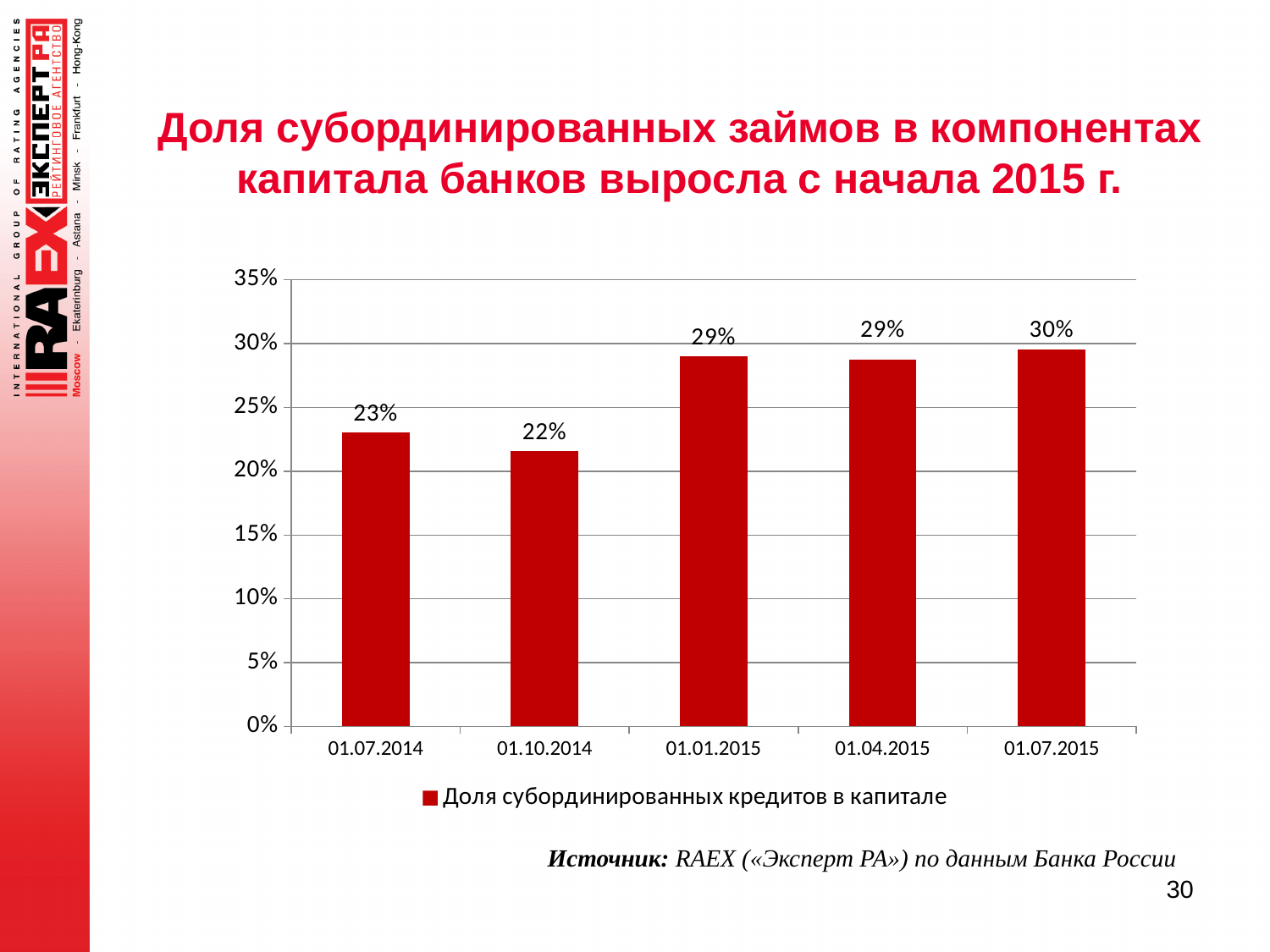
What is the difference between the values for 01.07.2015 and 01.10.2014? 8 percentage points What is the value for 01.01.2015? 29% What is the value for 01.10.2014? 22% What is the value for 01.07.2014? 23% What kind of chart is shown on the slide? bar chart How many dates are shown on the x axis? 5 Is the value for 01.04.2015 greater or less than 25%? greater Which date has the lowest value? 01.10.2014 What is the legend entry for the series shown? Доля субординированных кредитов в капитале Which date has the highest value? 01.07.2015 Which is larger, the value for 01.07.2014 or the value for 01.01.2015? 01.01.2015 What is the value for 01.07.2015? 30%